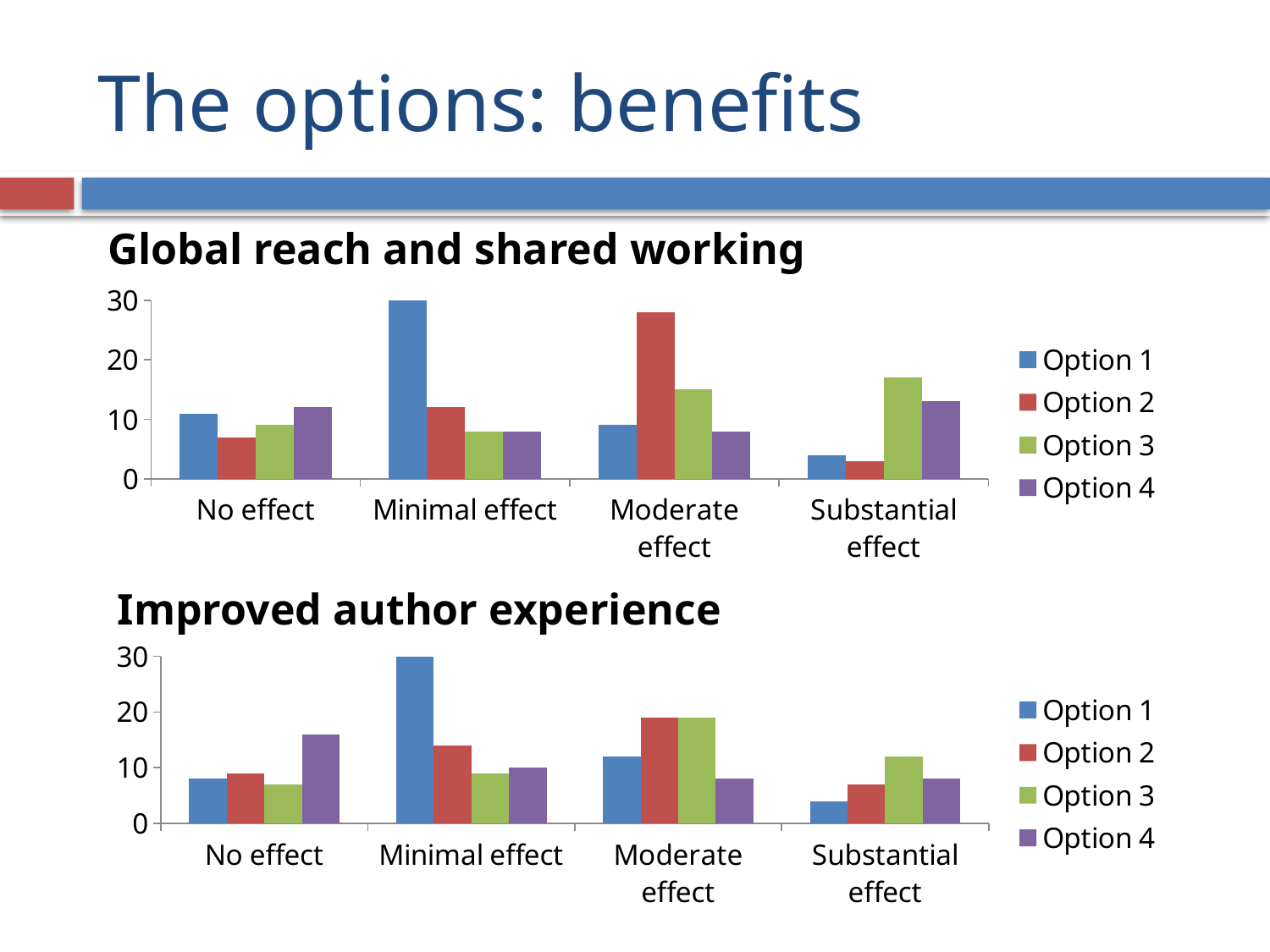
In the 'Improved author experience' chart, how many categories are shown on the x axis? 4 In the 'Global reach and shared working' chart, which option has the lowest bar for 'Substantial effect'? Option 2 In the 'Improved author experience' chart, which option has the highest bar for 'No effect'? Option 4 In the 'Global reach and shared working' chart, what kind of chart is shown? bar chart In the 'Global reach and shared working' chart, is the value for Option 2 at 'Moderate effect' greater or less than 20? greater In the 'Global reach and shared working' chart, is the value for Option 1 at 'Substantial effect' greater or less than 10? less In the 'Improved author experience' chart, what colour represents Option 3 in the legend? green In the 'Global reach and shared working' chart, which option has the highest bar for 'Minimal effect'? Option 1 In the 'Global reach and shared working' chart, how many series does the legend list? 4 In the 'Improved author experience' chart, is the value for Option 1 at 'Minimal effect' greater or less than 20? greater In the 'Improved author experience' chart, which is larger at 'Substantial effect': Option 1 or Option 3? Option 3 In the 'Global reach and shared working' chart, which option has the highest bar for 'Moderate effect'? Option 2